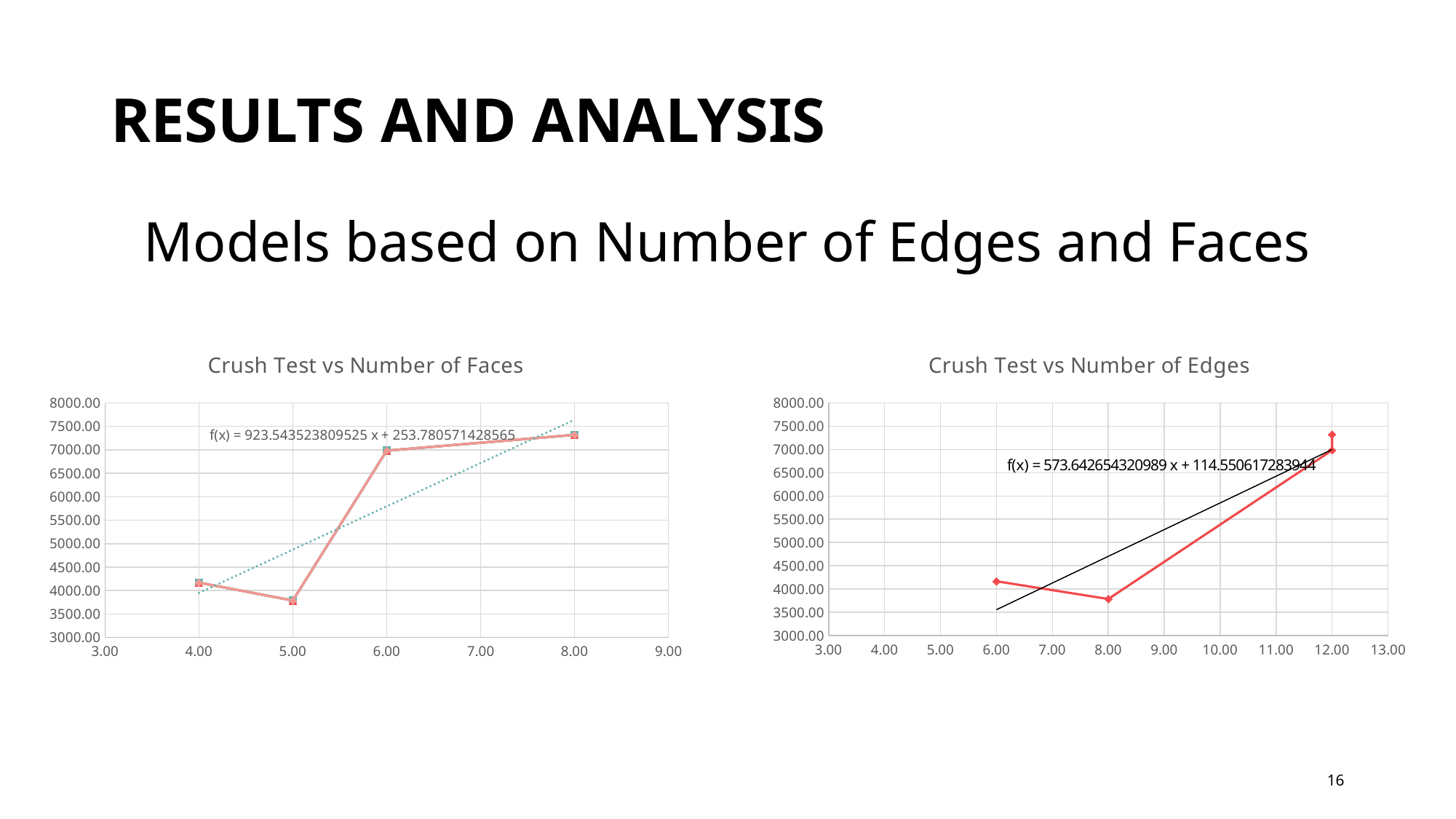
In the 'Crush Test vs Number of Faces' chart, at which x value is the plotted value highest? 8.00 What kind of chart is the 'Crush Test vs Number of Edges' chart? line chart In the 'Crush Test vs Number of Edges' chart, is the value at x = 6.00 greater or less than 4000.00? greater In the 'Crush Test vs Number of Faces' chart, which is larger, the value at x = 4.00 or the value at x = 5.00? 4.00 In the 'Crush Test vs Number of Faces' chart, at which x value is the plotted value lowest? 5.00 In the 'Crush Test vs Number of Edges' chart, is the value at x = 8.00 greater or less than 4000.00? less In the 'Crush Test vs Number of Edges' chart, at which x value is the plotted value lowest? 8.00 In the 'Crush Test vs Number of Edges' chart, at which x value is the plotted value highest? 12.00 What is the trendline equation shown on the 'Crush Test vs Number of Edges' chart? f(x) = 573.642654320989 x + 114.550617283944 In the 'Crush Test vs Number of Faces' chart, is the value at x = 5.00 greater or less than 4000.00? less What is the trendline equation shown on the 'Crush Test vs Number of Faces' chart? f(x) = 923.543523809525 x + 253.780571428565